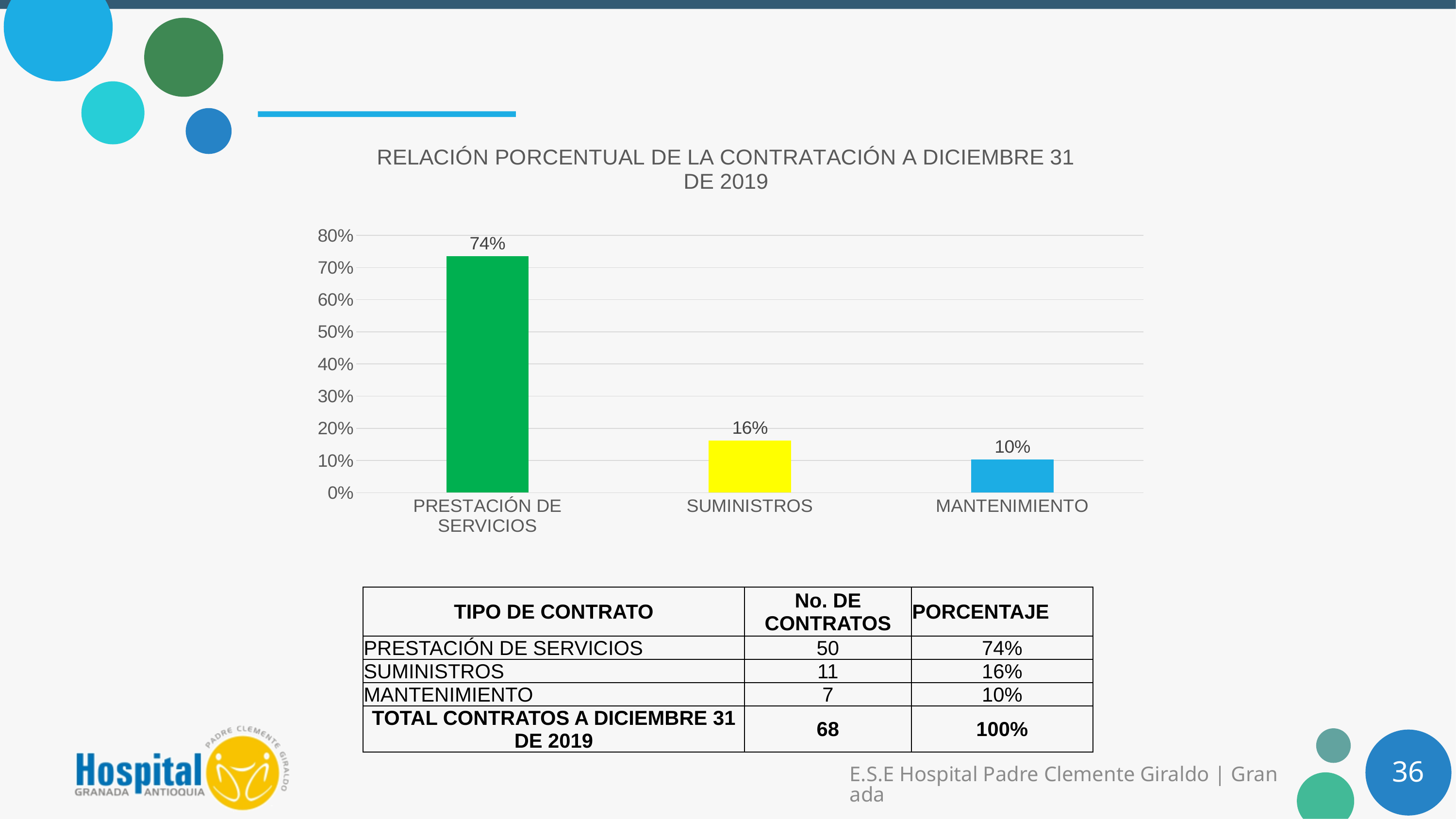
What is the difference between the values for SUMINISTROS and MANTENIMIENTO? 6% Which category has the highest value in the chart? PRESTACIÓN DE SERVICIOS What is the value for PRESTACIÓN DE SERVICIOS in the chart? 74% What is the value for SUMINISTROS in the chart? 16% Is the value for PRESTACIÓN DE SERVICIOS greater or less than 70%? greater What kind of chart is shown on the slide? Bar chart What is the value for MANTENIMIENTO in the chart? 10% What is the title of the chart? RELACIÓN PORCENTUAL DE LA CONTRATACIÓN A DICIEMBRE 31 DE 2019 Which is larger, the value for SUMINISTROS or the value for MANTENIMIENTO? SUMINISTROS What is the difference between the values for PRESTACIÓN DE SERVICIOS and SUMINISTROS? 58% Which category has the lowest value in the chart? MANTENIMIENTO How many categories are shown in the chart? 3